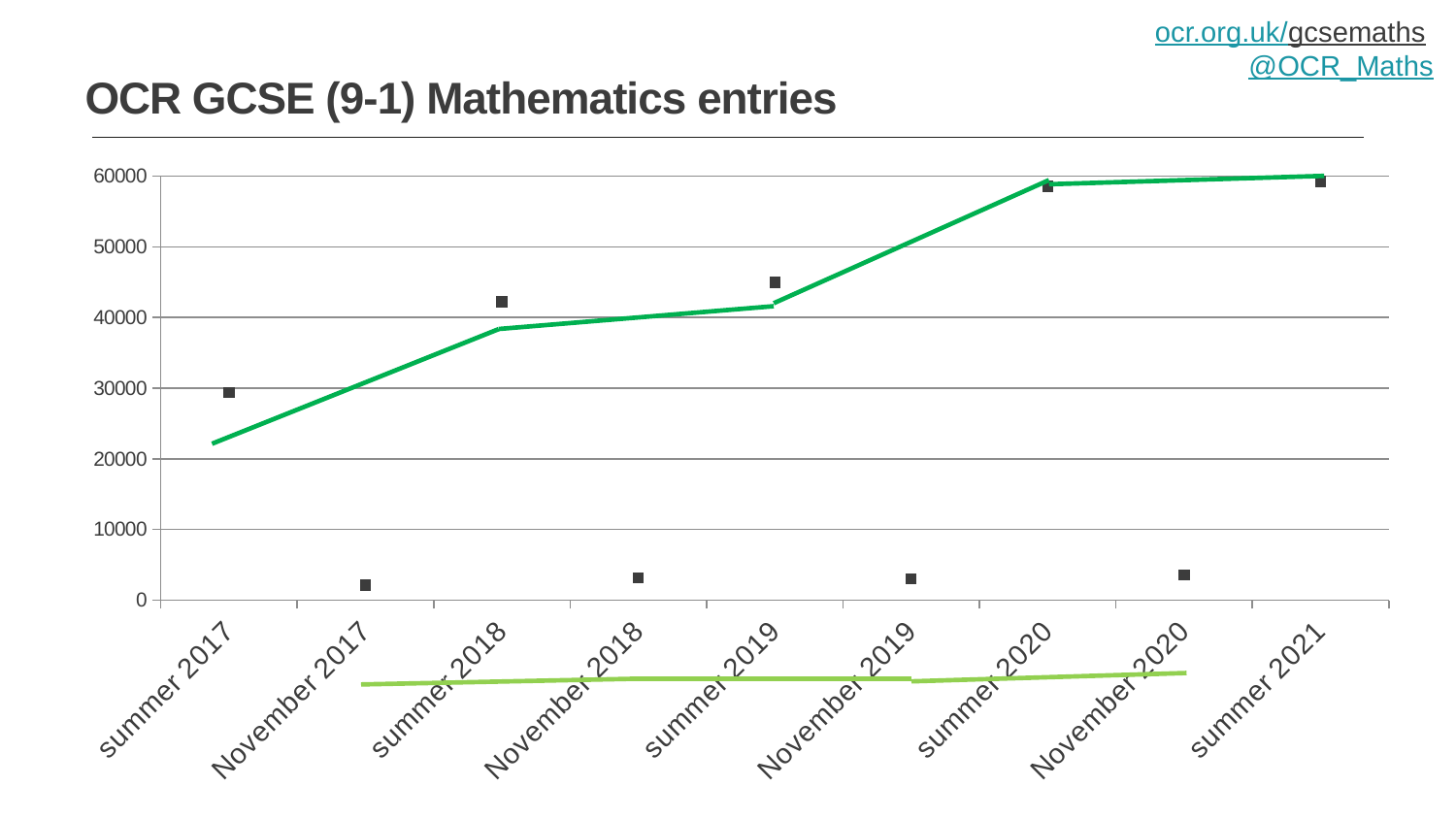
Which is larger, the value for summer 2019 or the value for November 2019? summer 2019 What kind of chart is shown on the slide? line chart Which is larger, the value for summer 2020 or the value for summer 2018? summer 2020 Is the value for summer 2017 greater or less than 40000? less Is the value for summer 2020 greater or less than 50000? greater Is the value for summer 2018 greater or less than 40000? greater What is the title of the chart? OCR GCSE (9-1) Mathematics entries How many exam sessions (categories) are shown on the x axis? 9 Do the summer entry values rise or fall from summer 2017 to summer 2021? rise